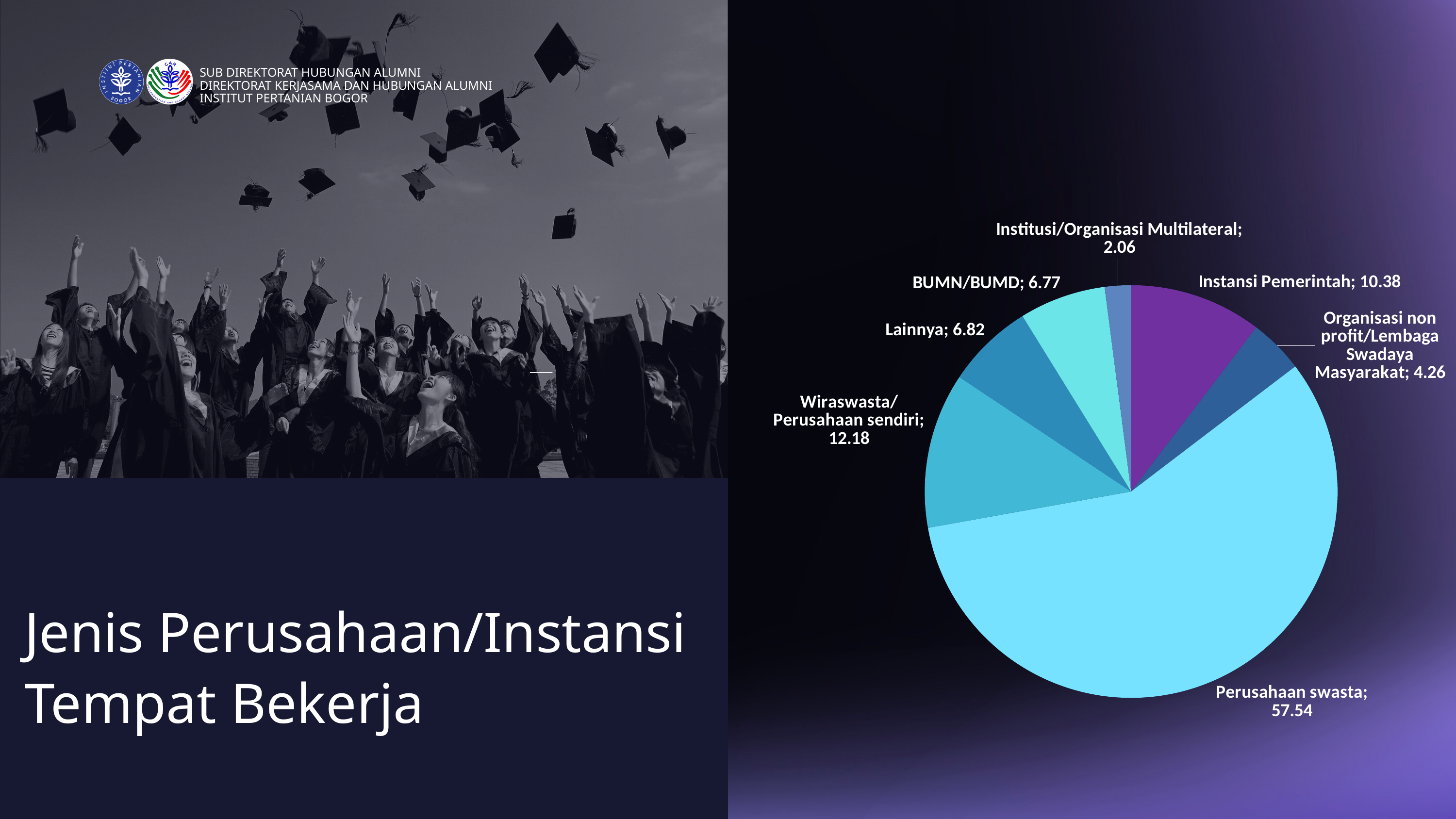
What is the difference between the values for Wiraswasta/Perusahaan sendiri and Instansi Pemerintah? 1.80 What is the value for Organisasi non profit/Lembaga Swadaya Masyarakat? 4.26 What is the value for Wiraswasta/Perusahaan sendiri? 12.18 Which category has the smallest slice of the pie? Institusi/Organisasi Multilateral What is the value for BUMN/BUMD? 6.77 Which is larger, the value for Lainnya or the value for Organisasi non profit/Lembaga Swadaya Masyarakat? Lainnya What is the value for Perusahaan swasta? 57.54 What is the value for Instansi Pemerintah? 10.38 What is the title of the slide containing the pie chart? Jenis Perusahaan/Instansi Tempat Bekerja Which category has the largest slice of the pie? Perusahaan swasta How many categories are shown in the pie chart? 7 What kind of chart is shown on the slide? Pie chart